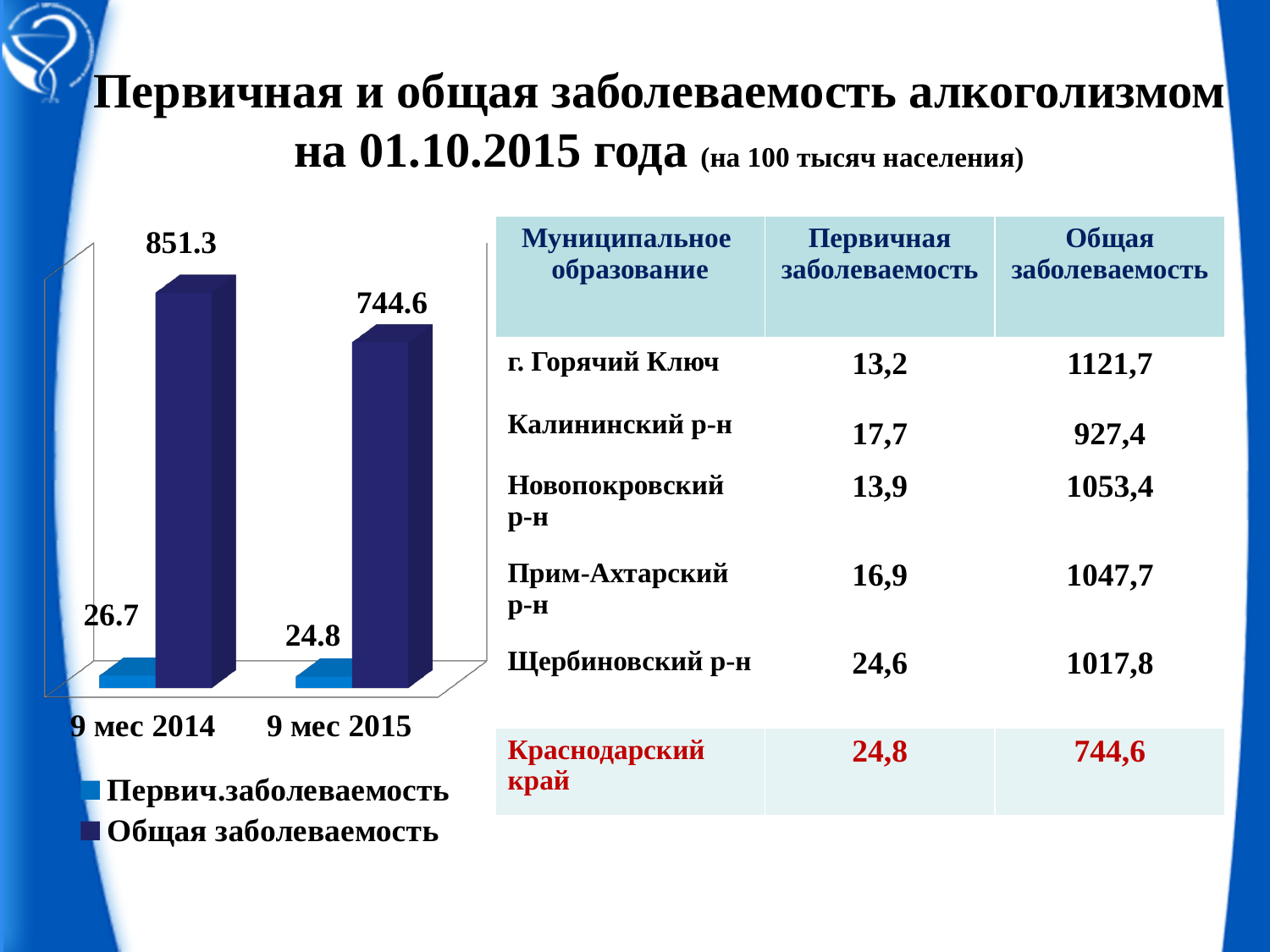
What is the value of Первич.заболеваемость for 9 мес 2015? 24.8 What is the value of Общая заболеваемость for 9 мес 2014? 851.3 How many periods are shown on the x axis of the chart? 2 What is the difference between Общая заболеваемость for 9 мес 2014 and 9 мес 2015? 106.7 What is the value of Первич.заболеваемость for 9 мес 2014? 26.7 How many series does the chart legend list? 2 Is Общая заболеваемость for 9 мес 2014 larger or smaller than for 9 мес 2015? larger What is the difference between Первич.заболеваемость for 9 мес 2014 and 9 мес 2015? 1.9 Which period has the lower value of Первич.заболеваемость? 9 мес 2015 What kind of chart is shown on the slide? bar chart What is the value of Общая заболеваемость for 9 мес 2015? 744.6 Which period has the higher value of Общая заболеваемость? 9 мес 2014